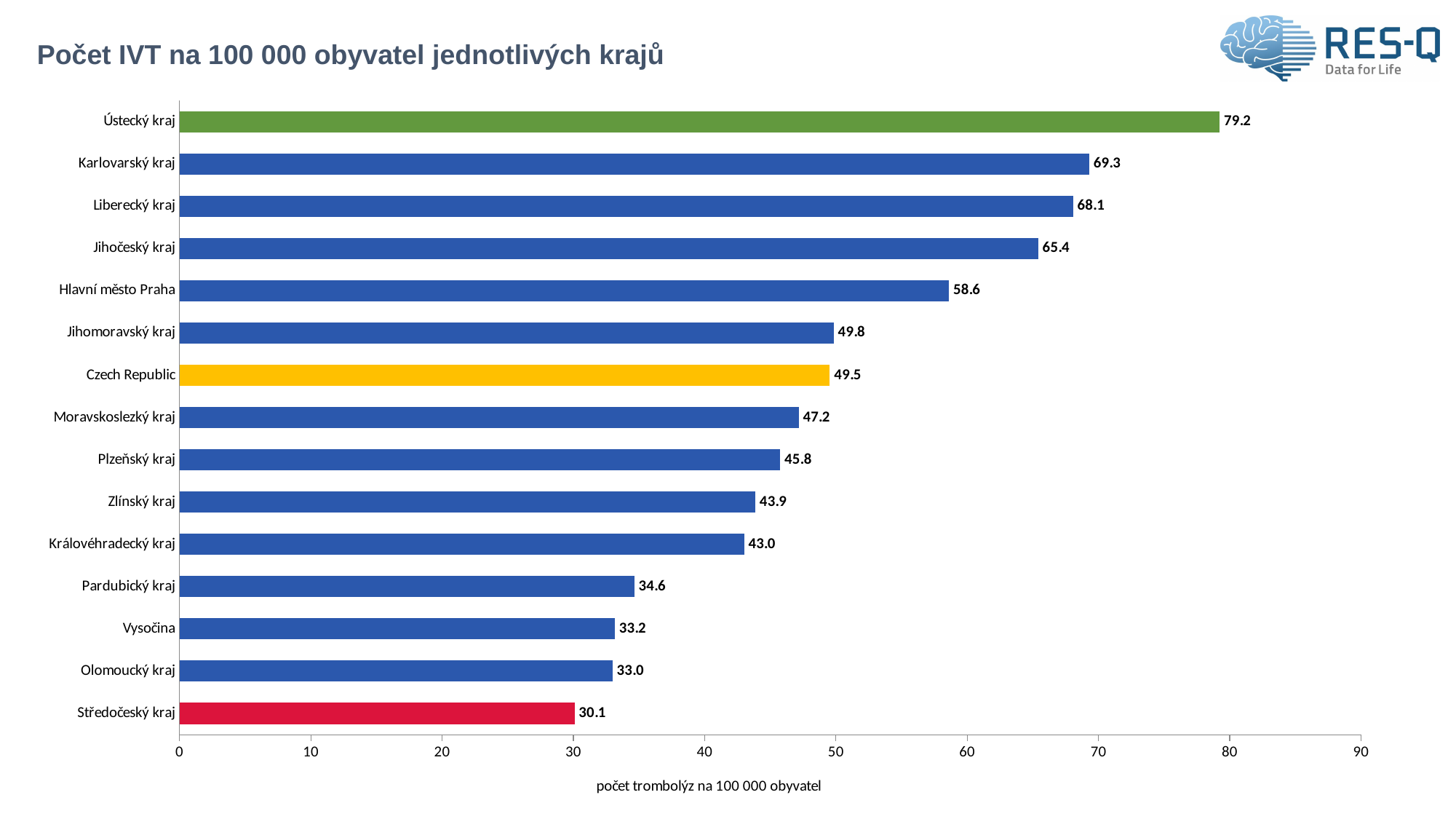
What is the value for Hlavní město Praha? 58.6 What is the difference between the values for Ústecký kraj and Středočeský kraj? 49.1 What is the value for Ústecký kraj? 79.2 What is the title of the chart? Počet IVT na 100 000 obyvatel jednotlivých krajů Is the value for Pardubický kraj greater or less than 40? less What kind of chart is shown on the slide? bar chart Which category has the lowest value? Středočeský kraj How many categories are shown on the chart? 15 What is the difference between the values for Karlovarský kraj and Liberecký kraj? 1.2 What is the value for Czech Republic? 49.5 Which category has the highest value? Ústecký kraj Which is larger, the value for Jihočeský kraj or the value for Hlavní město Praha? Jihočeský kraj